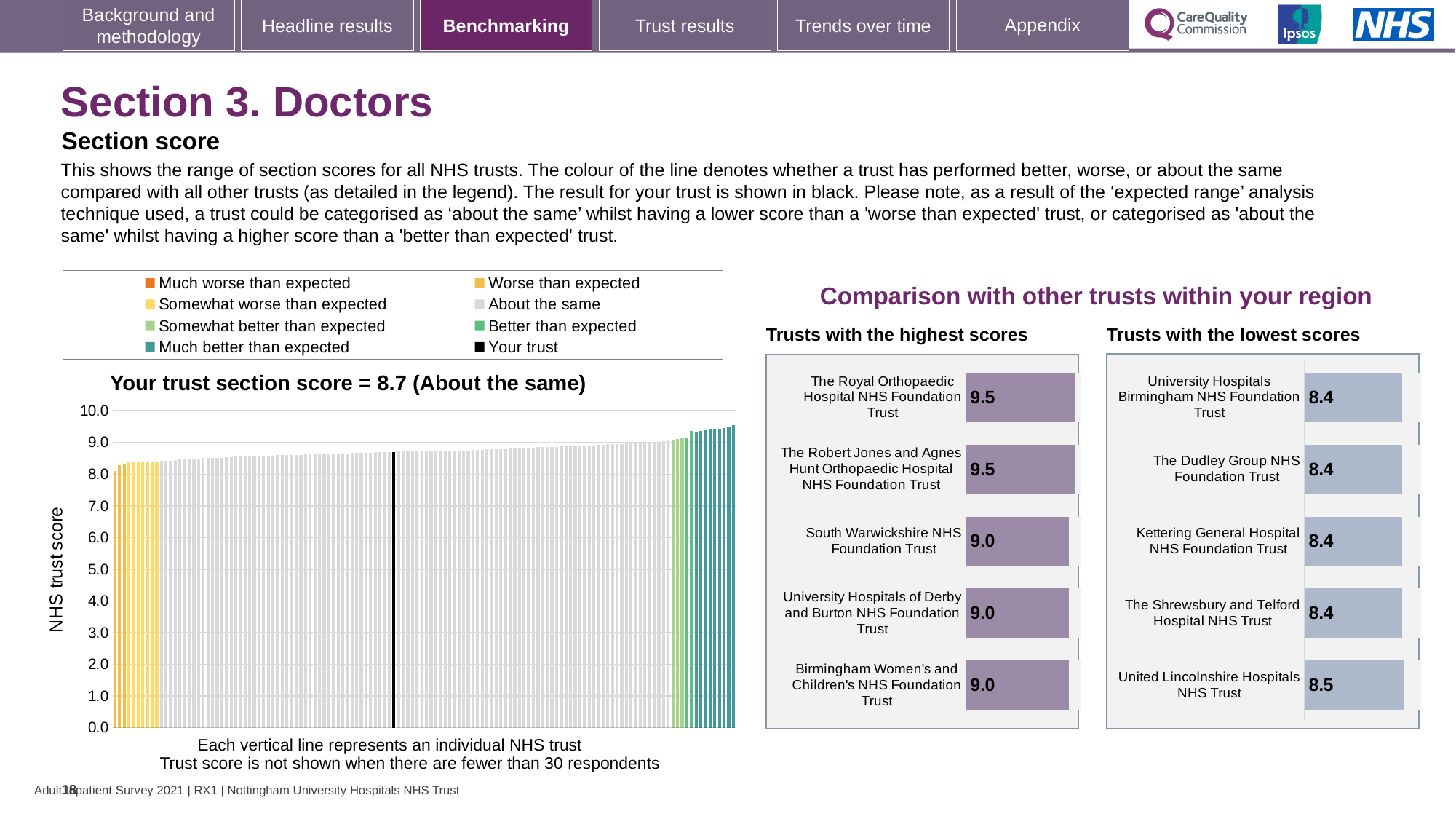
In the 'Trusts with the highest scores' chart, how many trusts are listed? 5 In the 'Trusts with the lowest scores' chart, which trust has the highest score? United Lincolnshire Hospitals NHS Trust In the 'Trusts with the highest scores' chart, what is the score for South Warwickshire NHS Foundation Trust? 9.0 In the 'Trusts with the lowest scores' chart, which has the larger score: United Lincolnshire Hospitals NHS Trust or The Dudley Group NHS Foundation Trust? United Lincolnshire Hospitals NHS Trust What is the section score for your trust shown in the title of the left-hand chart? 8.7 How many entries does the legend above the left-hand chart list? 8 In the 'Trusts with the highest scores' chart, what is the difference between the scores of The Royal Orthopaedic Hospital NHS Foundation Trust and South Warwickshire NHS Foundation Trust? 0.5 In the 'Trusts with the lowest scores' chart, what is the score for Kettering General Hospital NHS Foundation Trust? 8.4 What is the label on the vertical axis of the left-hand chart? NHS trust score In the 'Trusts with the highest scores' chart, what is the score for The Royal Orthopaedic Hospital NHS Foundation Trust? 9.5 In the left-hand chart of all NHS trusts, do the bars rise or fall from left to right along the x axis? rise What kind of chart is the left-hand chart showing the range of section scores for all NHS trusts? bar chart